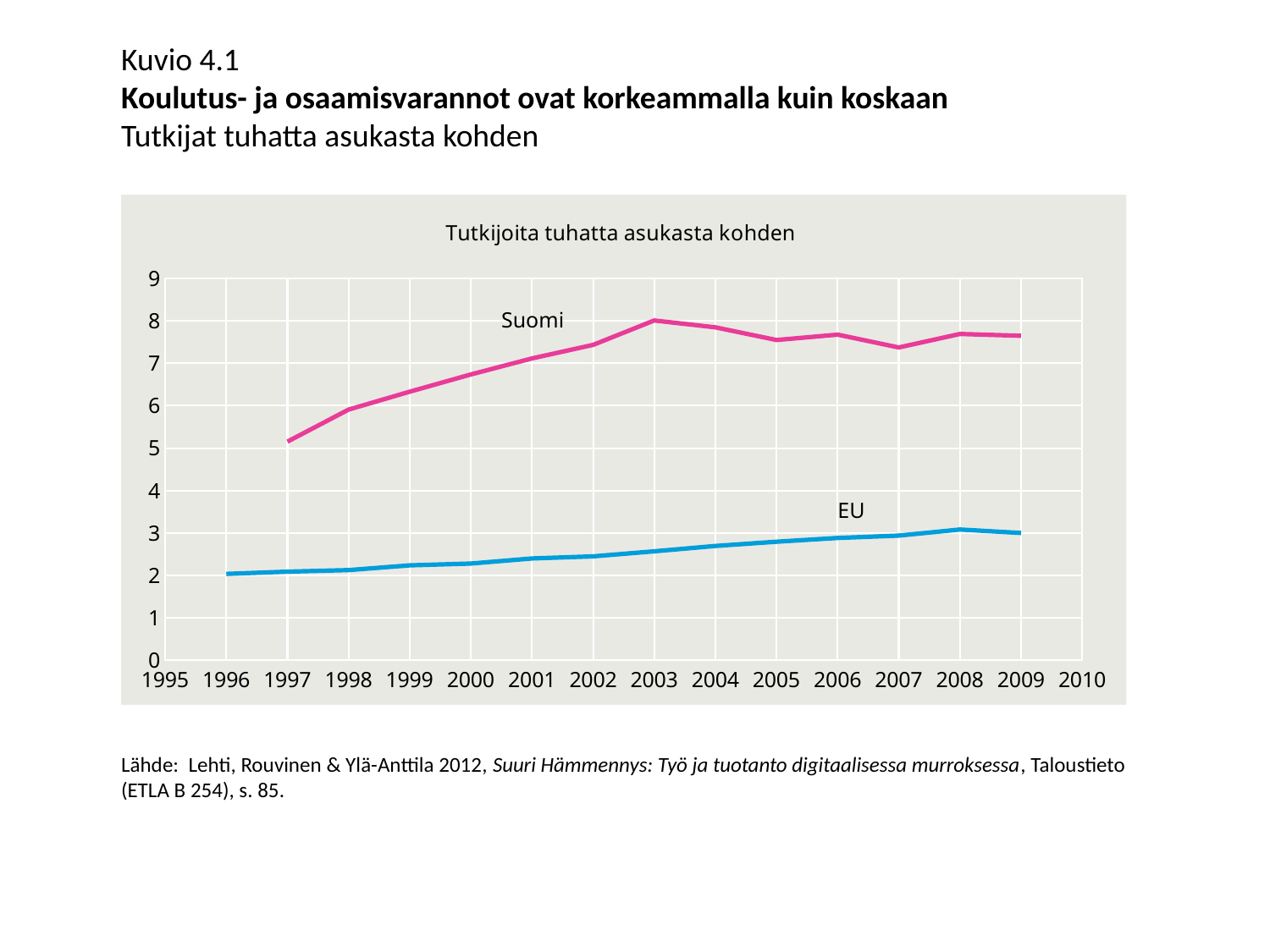
What is the title shown inside the chart area? Tutkijoita tuhatta asukasta kohden Is the value for EU in 1996 greater or less than 3? less Which series has the higher value in 2005, Suomi or EU? Suomi Does the EU line rise or fall from 1996 to 2008? rise How many series are plotted in the chart? 2 Is the value for EU in 2008 greater or less than 2? greater What kind of chart is shown on the slide? line chart Is the value for Suomi in 1997 greater or less than 6? less Which colour is the Suomi line drawn in? pink In which year does the Suomi line reach its highest value? 2003